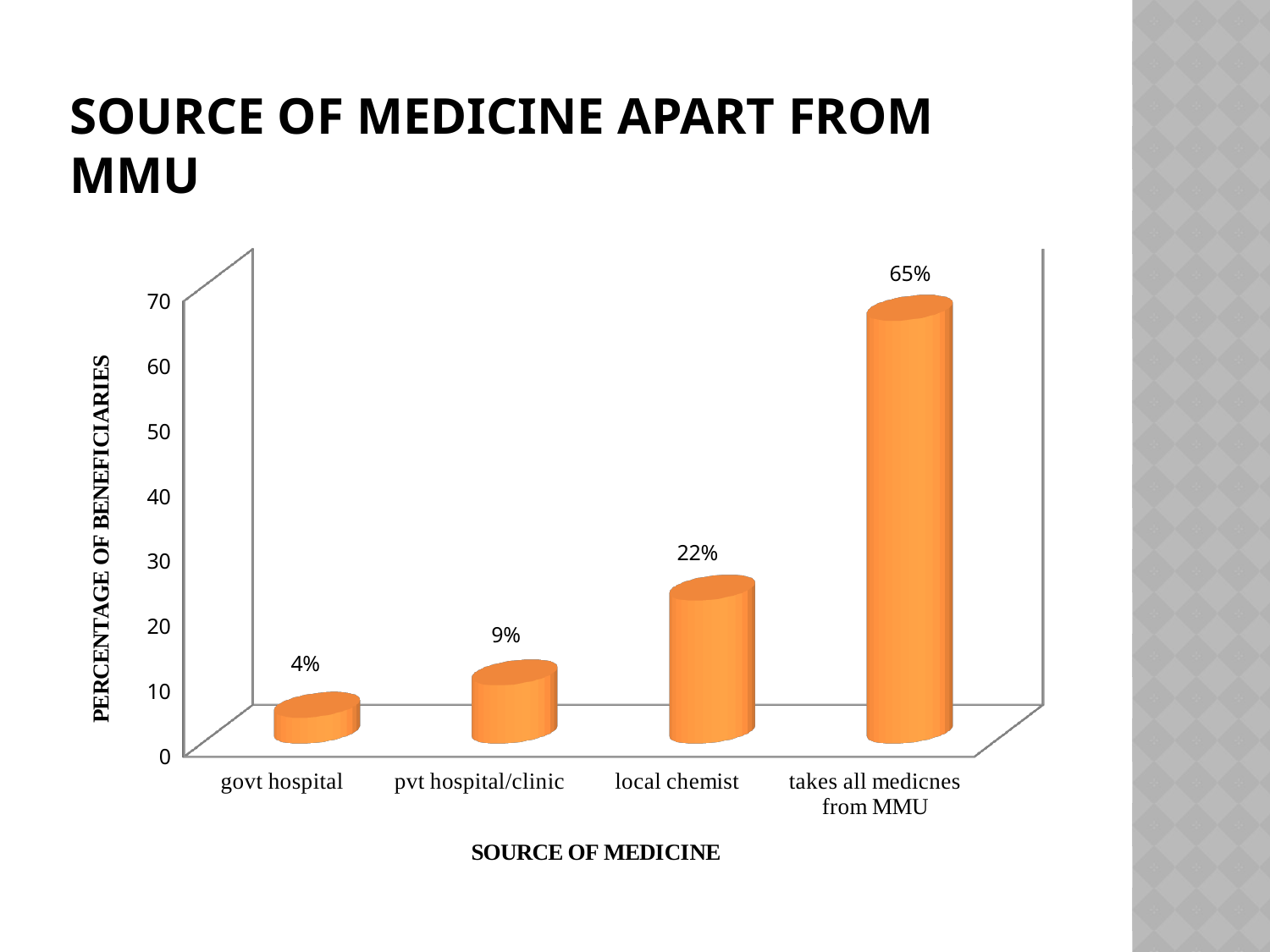
How many categories are shown on the x axis? 4 What is the difference between the values for takes all medicnes from MMU and local chemist? 43% What is the value for pvt hospital/clinic? 9% Which is larger, the value for pvt hospital/clinic or the value for local chemist? local chemist What is the value for takes all medicnes from MMU? 65% What kind of chart is shown on the slide? bar chart What is the value for local chemist? 22% Which category has the highest value? takes all medicnes from MMU Do the values rise or fall from left to right along the x axis? rise Which category has the lowest value? govt hospital What is the label of the y axis? PERCENTAGE OF BENEFICIARIES What is the value for govt hospital? 4%